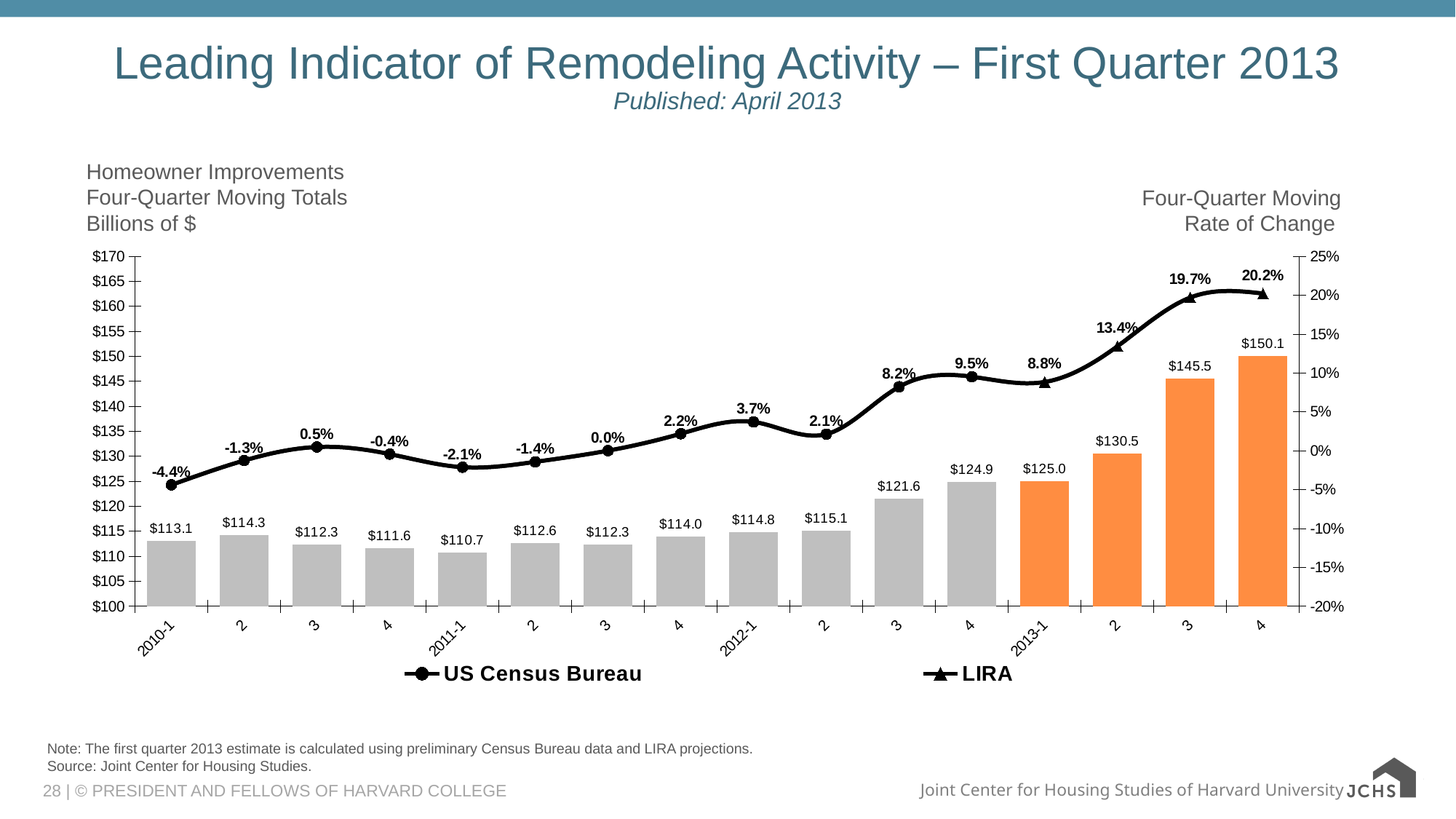
What is the difference between the four-quarter moving totals for 2013-3 and 2013-2? $15.0 Which quarter has the lowest four-quarter moving total? 2011-1 What is the four-quarter moving total for 2013-4? $150.1 What is the lowest four-quarter moving rate of change shown? -4.4% Which quarter has the highest four-quarter moving rate of change? 2013-4 What is the four-quarter moving rate of change for 2012-3? 8.2% What is the four-quarter moving total for 2011-1? $110.7 What are the two series named in the legend? US Census Bureau and LIRA Do the four-quarter moving totals rise or fall from 2012-2 to 2013-4? rise How many quarters are plotted on the x axis? 16 Which is larger, the rate of change for 2012-4 or for 2013-1? 2012-4 How many series does the legend list? 2